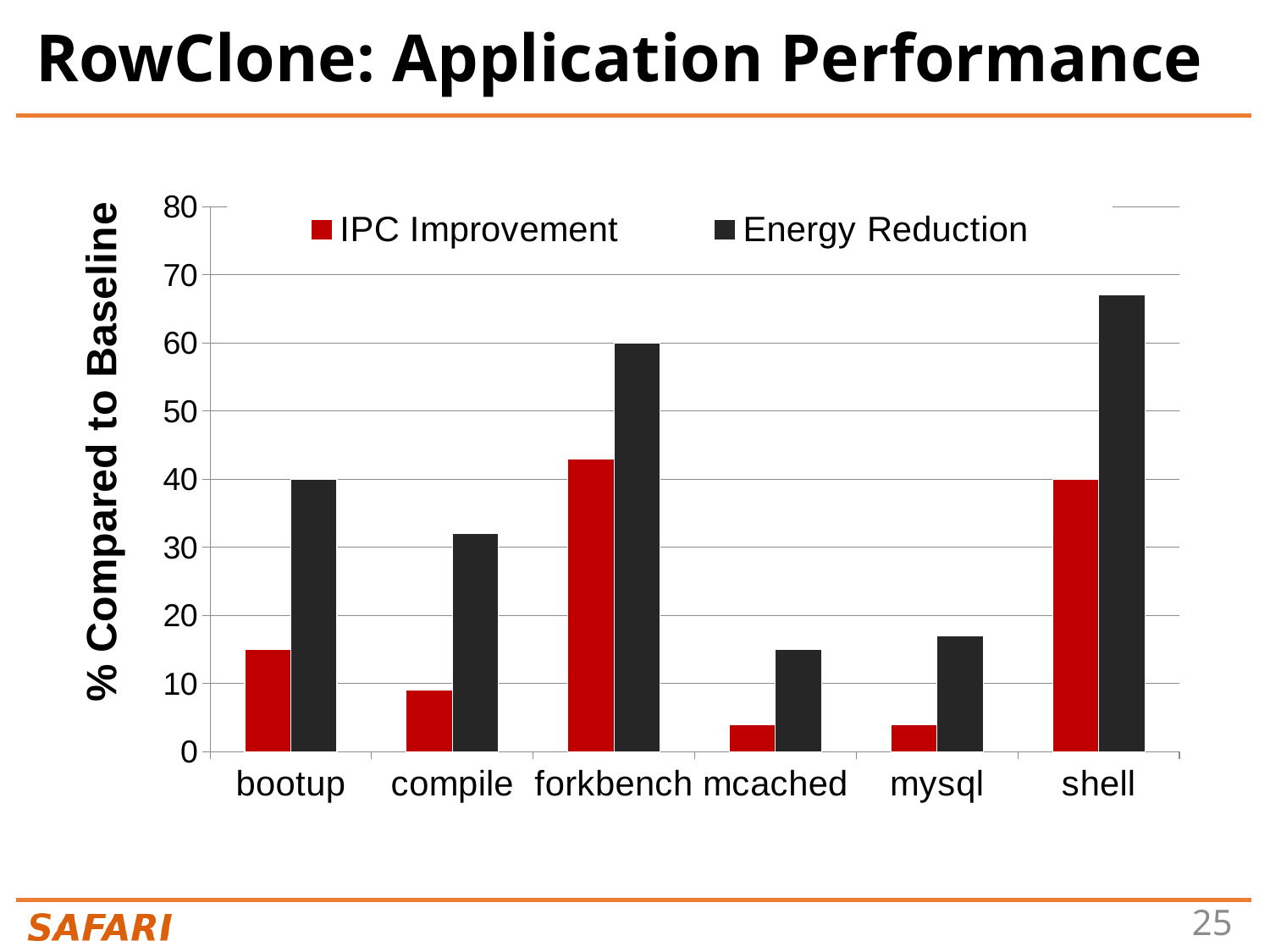
Is the IPC Improvement for mcached greater or less than 10? less Which application has the highest Energy Reduction? shell What is the Energy Reduction value for forkbench? 60 How many series does the legend list? 2 What type of chart is shown on the slide? bar chart How many applications are shown on the x axis? 6 Is the Energy Reduction for compile greater or less than 30? greater What is the title of the y axis? % Compared to Baseline Which is larger, the Energy Reduction for bootup or the Energy Reduction for compile? bootup What is the IPC Improvement value for shell? 40 Which application has the highest IPC Improvement? forkbench What is the Energy Reduction value for bootup? 40